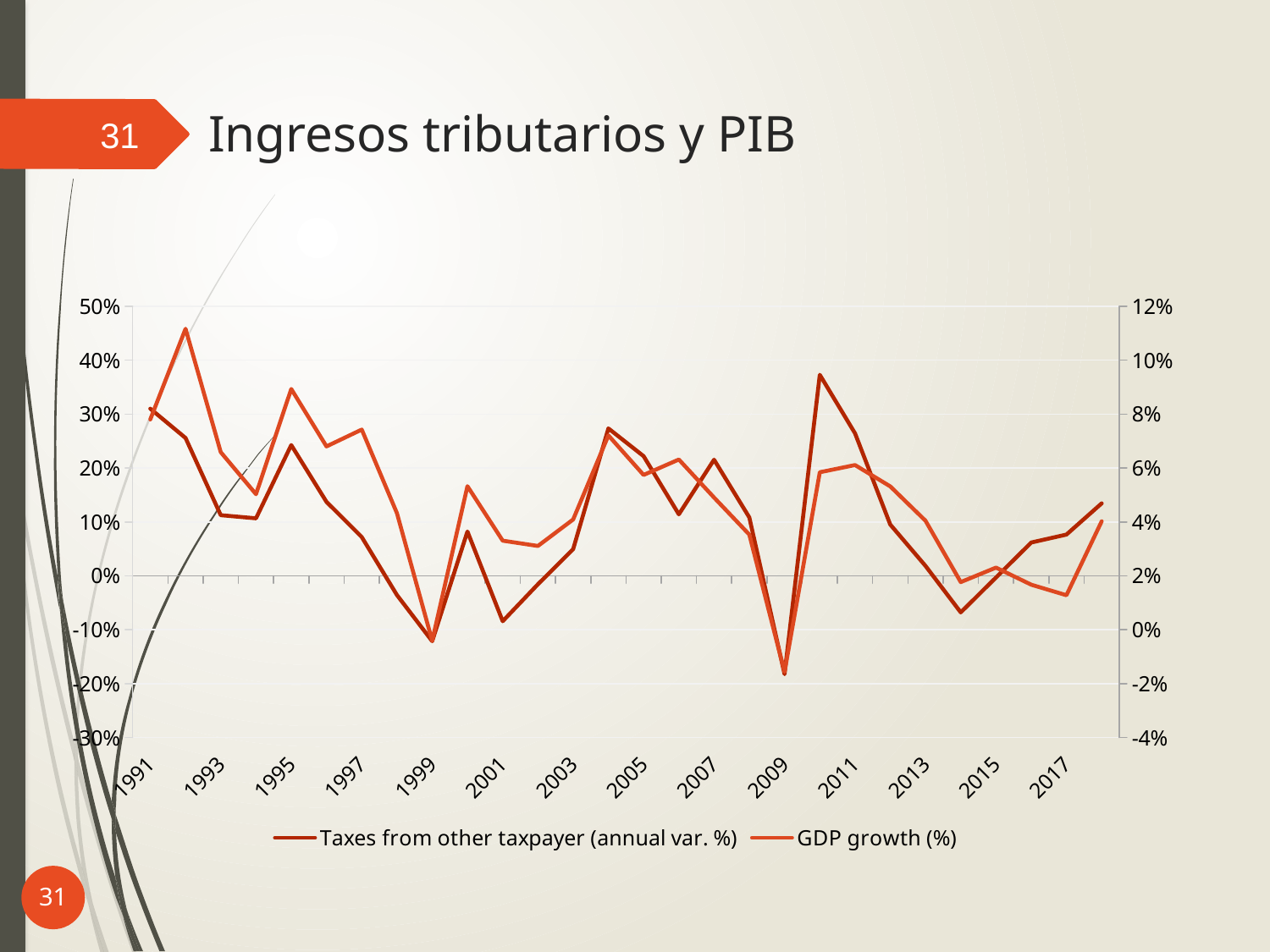
In which year does the 'GDP growth (%)' series reach its highest value? 1992 Does the 'GDP growth (%)' series rise or fall between 2015 and 2017? fall In which year does the 'GDP growth (%)' series reach its lowest value? 2009 How many series does the legend list? 2 What kind of chart is shown on the slide? line chart What is the title of the chart on the slide? Ingresos tributarios y PIB Which series is plotted against the right-hand axis that runs from -4% to 12%? GDP growth (%) Is the value for 'GDP growth (%)' in 2009 greater or less than 0%? less Is the value for 'Taxes from other taxpayer (annual var. %)' in 1991 greater or less than 20%? greater Is the value for 'Taxes from other taxpayer (annual var. %)' in 2009 greater or less than -10%? less In which year does the 'Taxes from other taxpayer (annual var. %)' series reach its highest value? 2010 In which year does the 'Taxes from other taxpayer (annual var. %)' series reach its lowest value? 2009